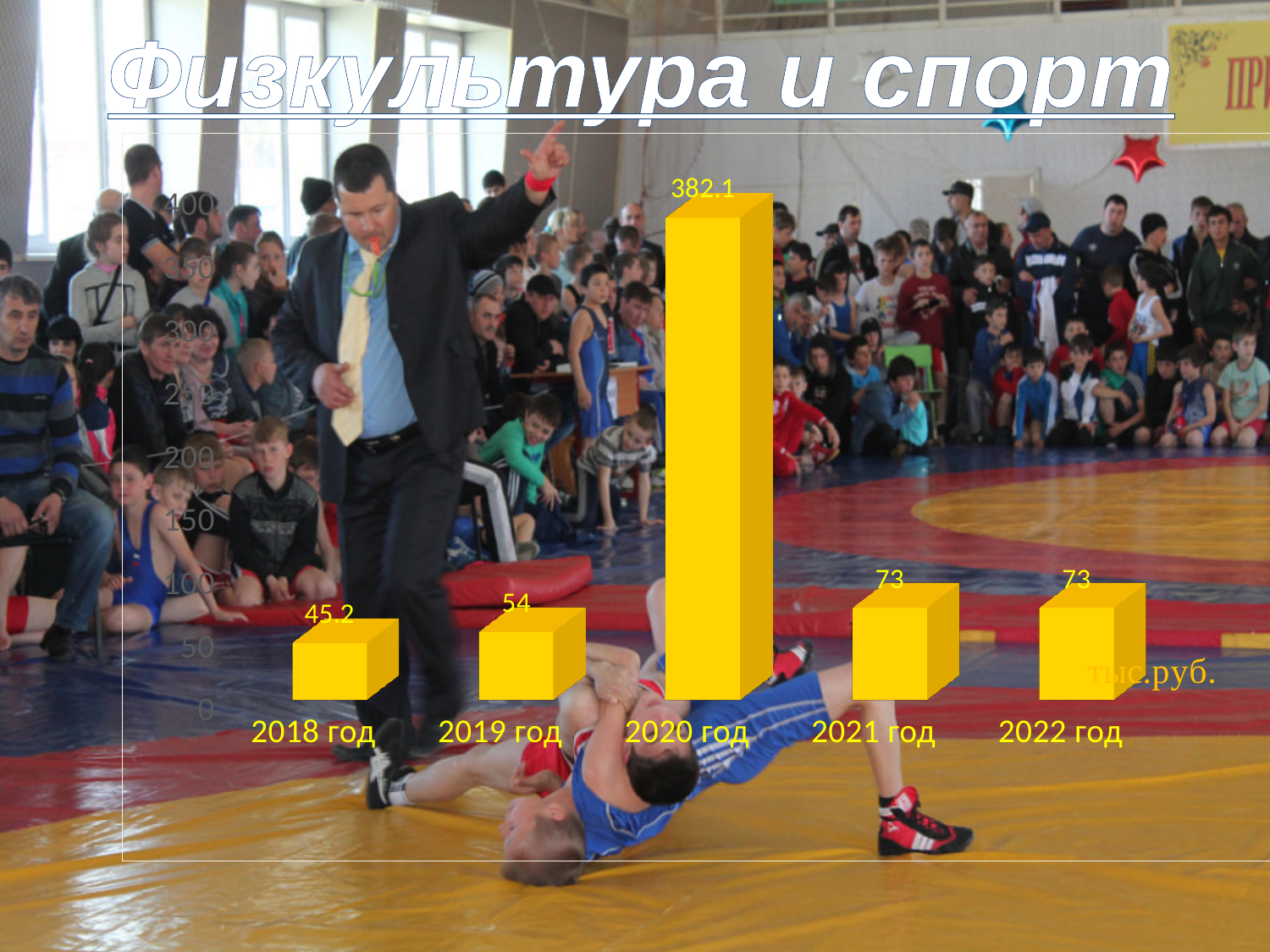
How many years are shown on the chart? 5 Is the value for 2020 год greater or less than 350? greater Which year has the highest value? 2020 год What is the difference between the values for 2019 год and 2018 год? 8.8 What is the value for 2020 год? 382.1 What is the value for 2021 год? 73 What is the value for 2018 год? 45.2 What kind of chart is shown on the slide? bar chart What unit label is shown next to the chart? тыс.руб. What is the difference between the values for 2020 год and 2022 год? 309.1 Which is larger, the value for 2019 год or the value for 2021 год? 2021 год Which year has the lowest value? 2018 год